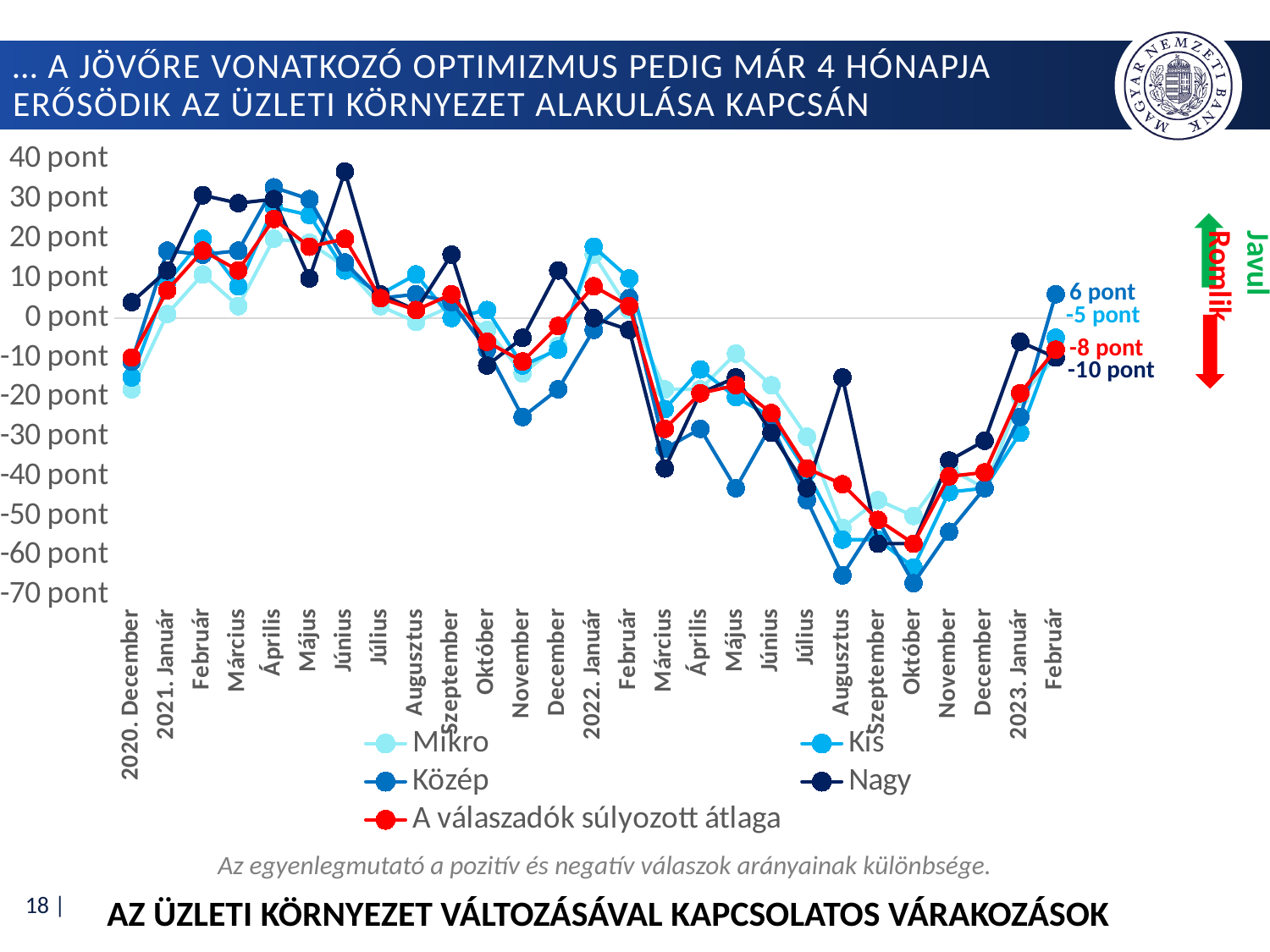
Which series has the highest value in 2023. Február? Közép Is the value of the Közép series in 2022. Október greater or less than -60 pont? less What is the difference between the Közép and Nagy values in 2023. Február? 16 pont What is the value of the Nagy series in 2023. Február? -10 pont How many months are shown on the x axis? 27 What is the value of the Kis series in 2023. Február? -5 pont Is the value of the Nagy series in 2021. Június greater or less than 30 pont? greater What kind of chart is shown on the slide? line chart What is the value of the Közép series in 2023. Február? 6 pont How many series does the legend list? 5 What is the value of 'A válaszadók súlyozott átlaga' in 2023. Február? -8 pont Does the 'A válaszadók súlyozott átlaga' series rise or fall from 2022. Október to 2023. Február? rise